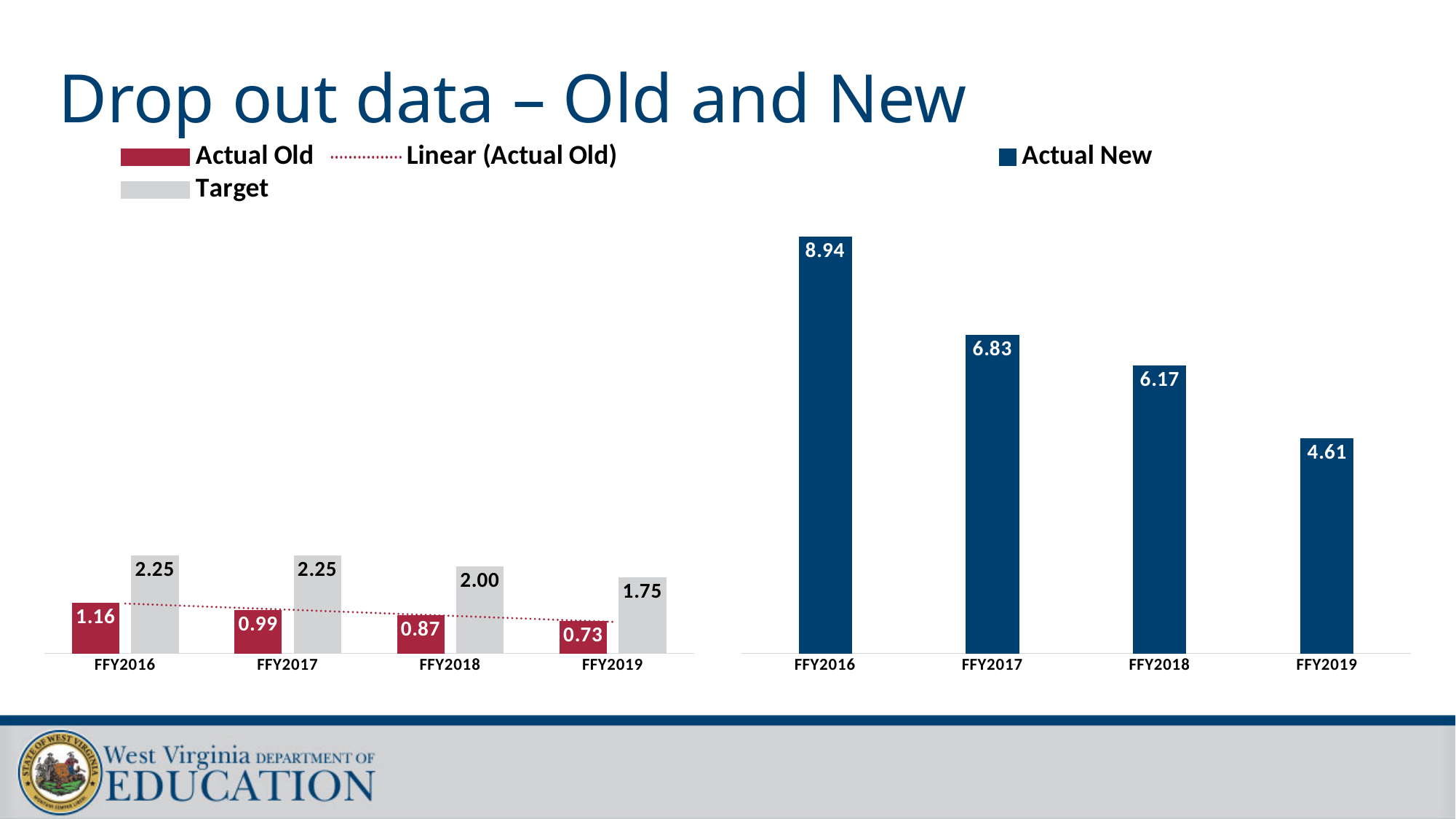
How many entries does the legend of the left chart list? 3 In the left chart, what is the difference between the Target and Actual Old values for FFY2019? 1.02 In the right chart, what is the difference between the Actual New values for FFY2016 and FFY2019? 4.33 What kind of chart is the right chart? bar chart In the left chart, what is the Target value for FFY2018? 2.00 How many years are shown on the x axis of the right chart? 4 In the left chart, which year has the lowest Actual Old value? FFY2019 In the right chart, what is the Actual New value for FFY2017? 6.83 In the right chart, which year has the highest Actual New value? FFY2016 In the right chart, do the Actual New values rise or fall from FFY2016 to FFY2019? fall In the left chart, what is the Actual Old value for FFY2016? 1.16 In the left chart, is the Actual Old value for FFY2017 larger or smaller than the Target value for FFY2017? smaller